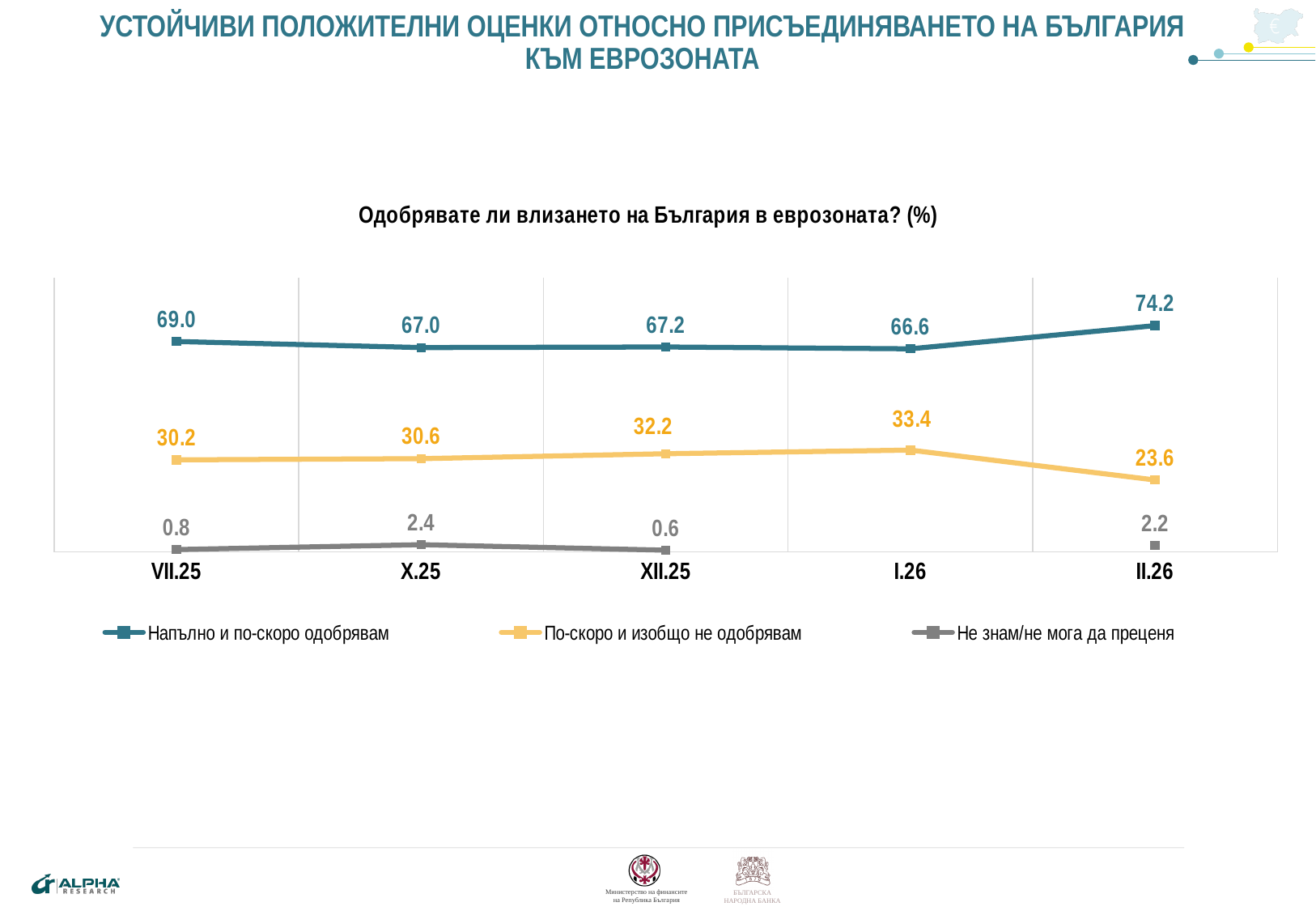
How many time periods are shown on the x axis? 5 What is the difference between the 'Напълно и по-скоро одобрявам' values in II.26 and I.26? 7.6 What is the value for 'Не знам/не мога да преценя' in X.25? 2.4 What kind of chart is shown on the slide? line chart In which period is the value for 'Напълно и по-скоро одобрявам' the highest? II.26 What is the title of the chart? Одобрявате ли влизането на България в еврозоната? (%) What is the value for 'Напълно и по-скоро одобрявам' in II.26? 74.2 How many series does the legend list? 3 Which is larger: the 'По-скоро и изобщо не одобрявам' value in I.26 or in II.26? I.26 What is the value for 'По-скоро и изобщо не одобрявам' in I.26? 33.4 Does the 'По-скоро и изобщо не одобрявам' series rise or fall between I.26 and II.26? fall In which period is the value for 'По-скоро и изобщо не одобрявам' the lowest? II.26